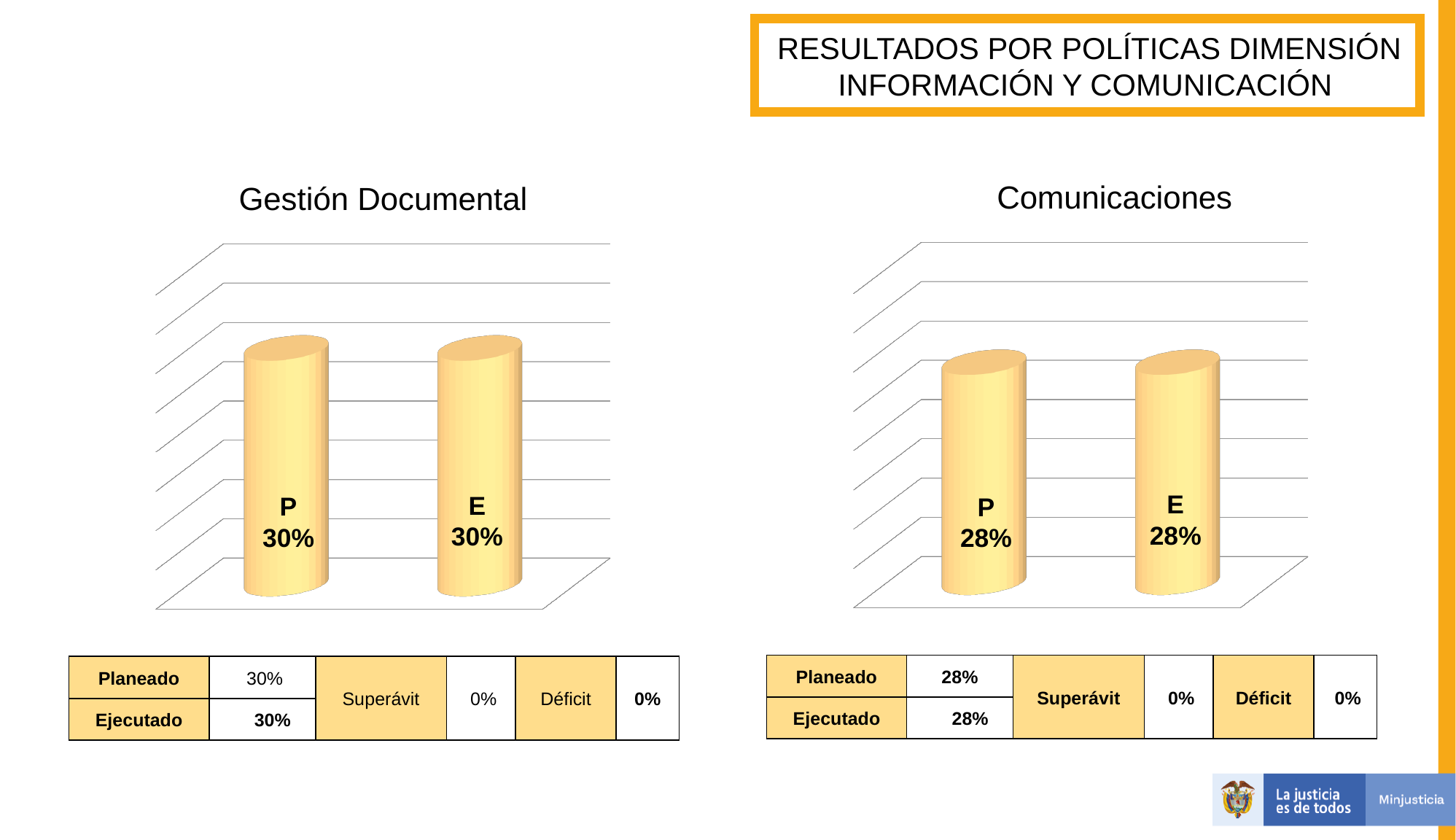
In the Comunicaciones chart, what is the difference between the P and E values? 0% How many bars does the Comunicaciones chart show? 2 What is the title of the chart on the left side of the slide? Gestión Documental In the Comunicaciones chart, what is the value for E? 28% In the Comunicaciones chart, what is the value for P? 28% What kind of chart is the Comunicaciones chart? Bar chart In the Gestión Documental chart, what is the value for E? 30% In the Gestión Documental chart, what is the value for P? 30% In the Gestión Documental chart, what is the difference between the P and E values? 0% What is the title of the chart on the right side of the slide? Comunicaciones What kind of chart is the Gestión Documental chart? Bar chart How many bars does the Gestión Documental chart show? 2